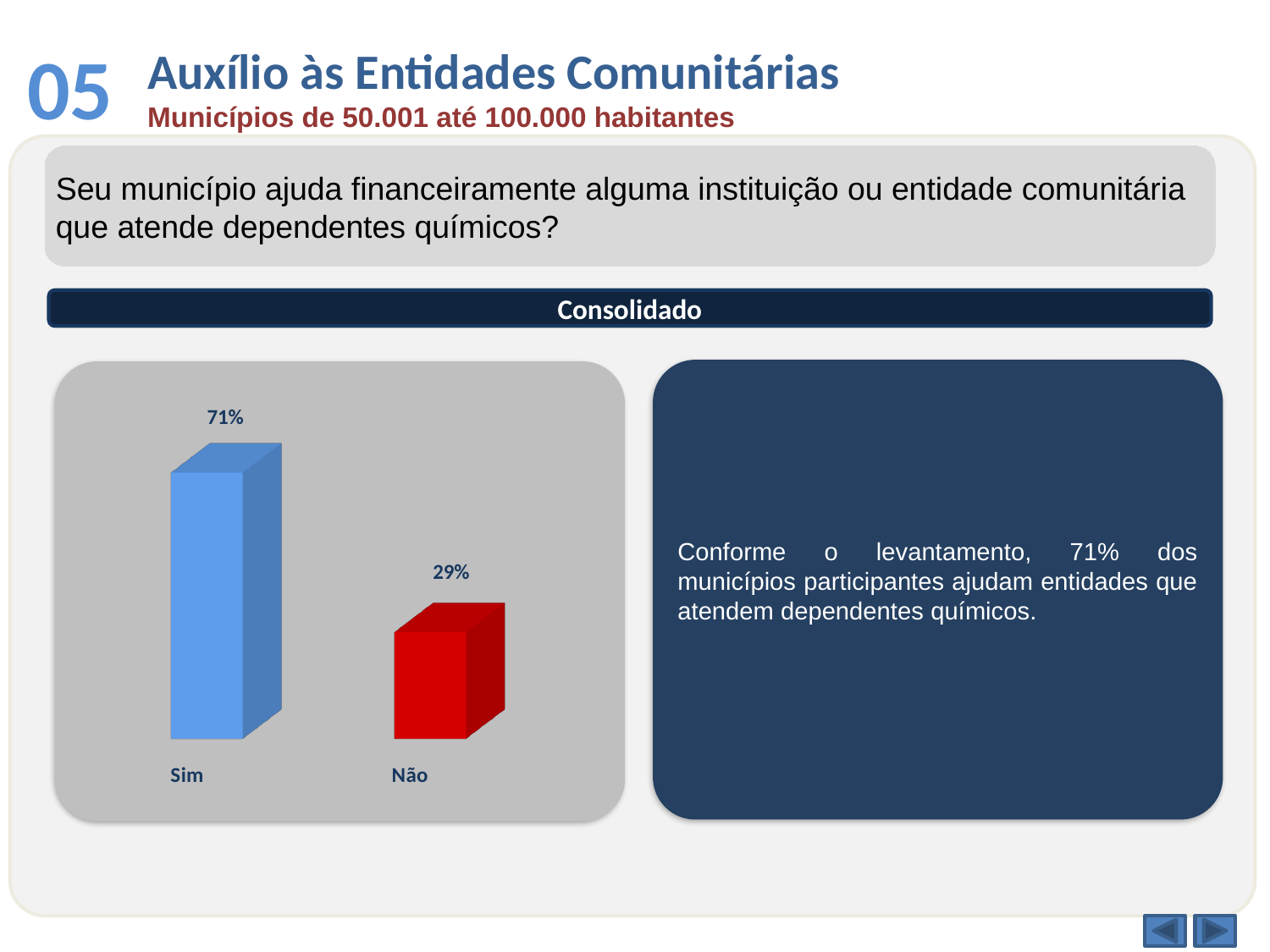
What is the value for Sim? 71% What colour is the bar for Sim? Blue How many categories are shown in the chart? 2 What colour is the bar for Não? Red What is the total of the values for Sim and Não? 100% Which is larger, the value for Sim or the value for Não? Sim What kind of chart is shown on the slide? Bar chart What is the value for Não? 29% Which category has the lowest value? Não What is the difference between the values for Sim and Não? 42% Which category has the highest value? Sim